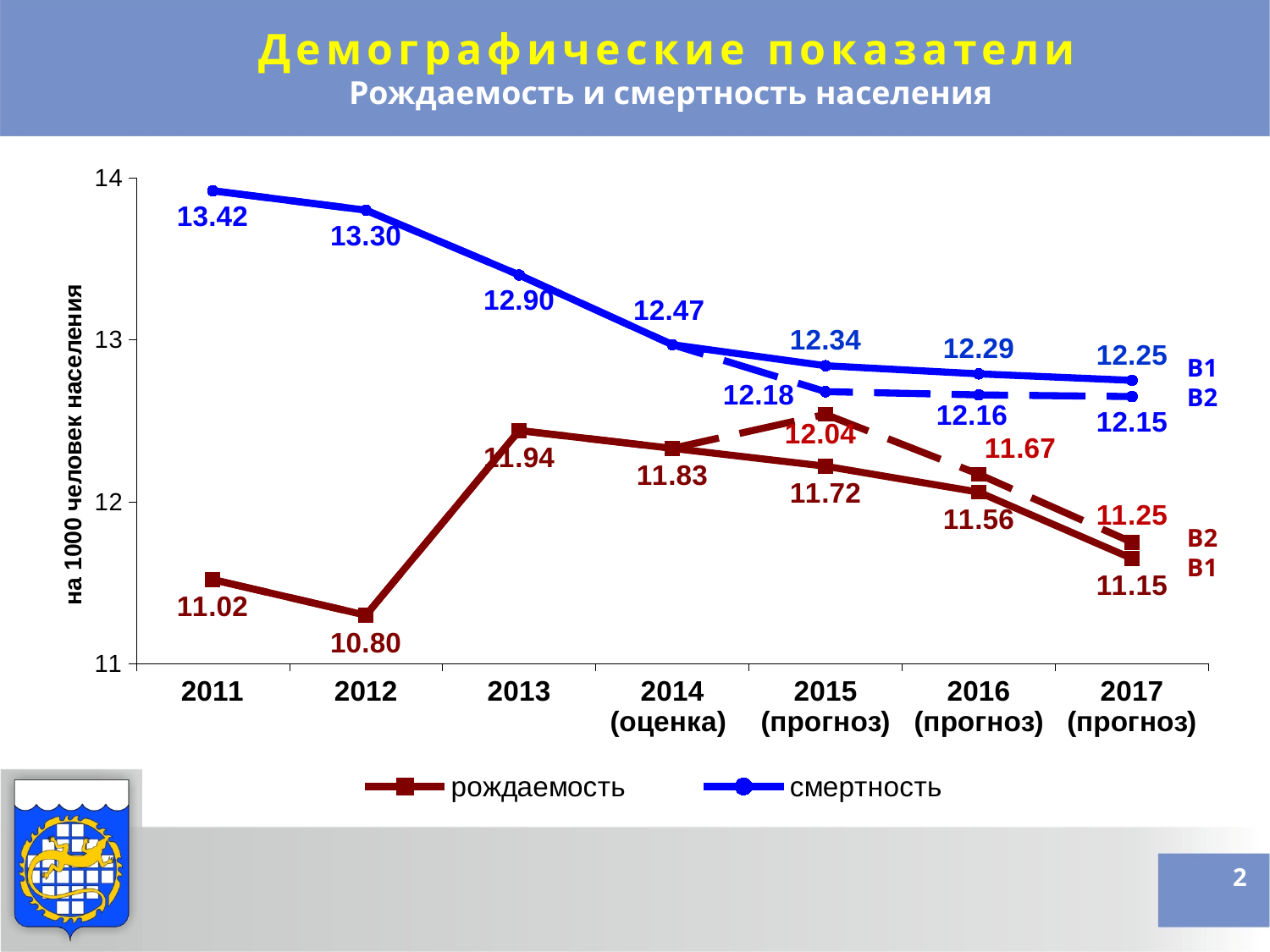
In which year is смертность highest? 2011 Which is larger in 2013, смертность or рождаемость? смертность What is the value of смертность in 2014 (оценка)? 12.47 Does смертность rise or fall from 2011 to 2014? fall What type of chart is shown on the slide? line chart What is the difference between смертность and рождаемость in 2011? 2.40 What is the B1 forecast value of смертность for 2017 (прогноз)? 12.25 What is the value of рождаемость in 2012? 10.80 What is the value of рождаемость in 2013? 11.94 How many series does the legend list? 2 What is the value of смертность in 2011? 13.42 In which year is рождаемость lowest? 2012